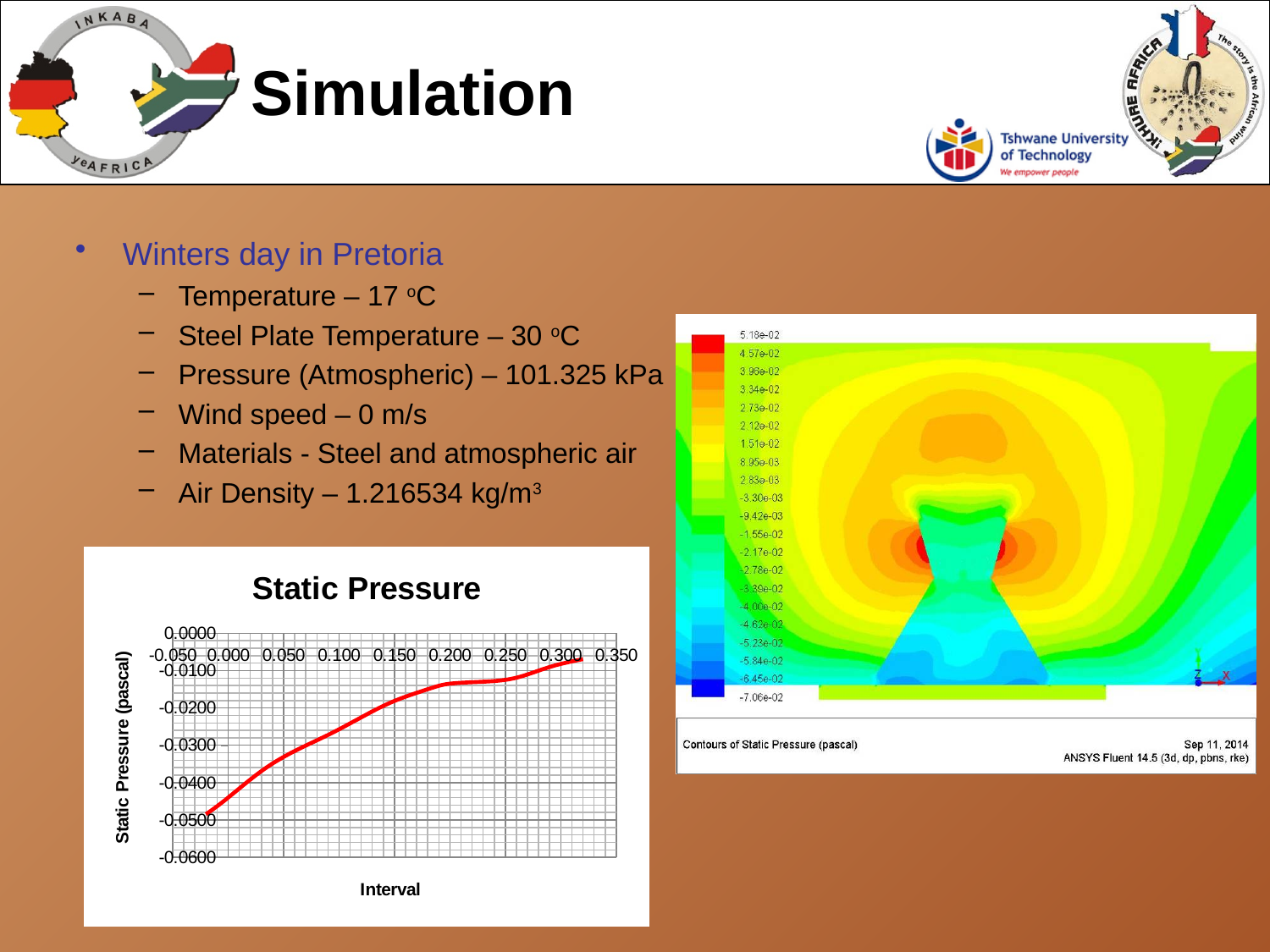
In the Static Pressure chart, is the value at Interval 0.050 greater or less than -0.0300? less In the Static Pressure chart, is the value at Interval 0.150 greater or less than -0.0300? greater In the Static Pressure chart, which has the larger static pressure: Interval 0.050 or Interval 0.200? 0.200 What is the title of the chart on the slide? Static Pressure What kind of chart is the Static Pressure chart? line chart What is the label of the vertical axis of the Static Pressure chart? Static Pressure (pascal) In the Static Pressure chart, is the value at Interval 0.000 greater or less than -0.0400? less In the Static Pressure chart, do the values rise or fall as Interval increases from 0.000 to 0.300? rise